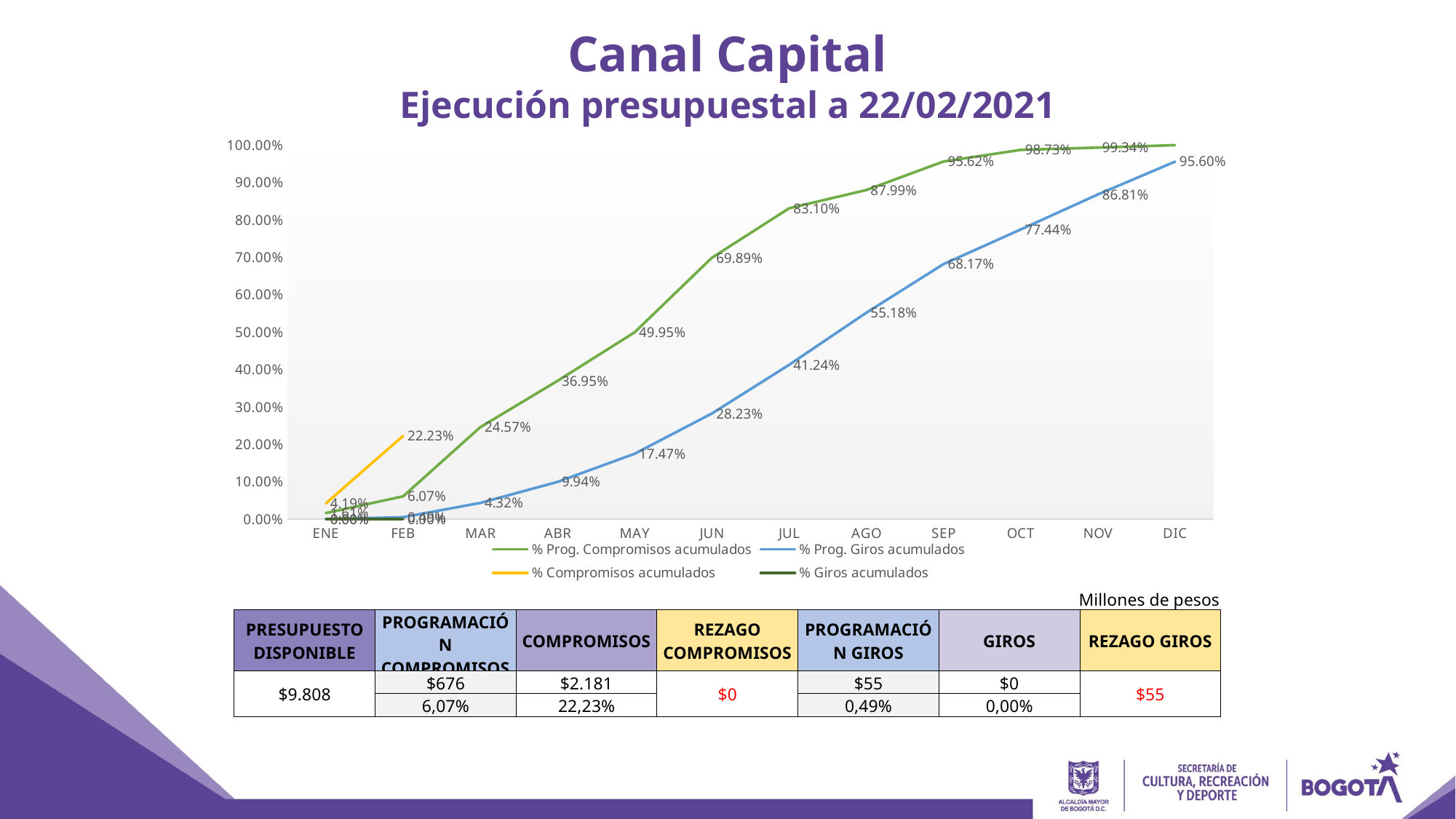
What is the value of % Prog. Giros acumulados in DIC? 95.60% Which colour is used for the % Prog. Giros acumulados series? blue What is the value of % Compromisos acumulados in FEB? 22.23% What is the difference between % Prog. Compromisos acumulados and % Prog. Giros acumulados in SEP? 27.45% How many series does the chart legend list? 4 What type of chart is shown on the slide? line chart What is the value of % Prog. Giros acumulados in AGO? 55.18% What is the value of % Prog. Compromisos acumulados in JUN? 69.89% Does the % Prog. Giros acumulados series rise or fall from ENE to DIC? rise How many months are shown on the x axis of the chart? 12 Is the value of % Prog. Compromisos acumulados in DIC greater or less than 90.00%? greater Which is larger in FEB: % Compromisos acumulados or % Prog. Compromisos acumulados? % Compromisos acumulados